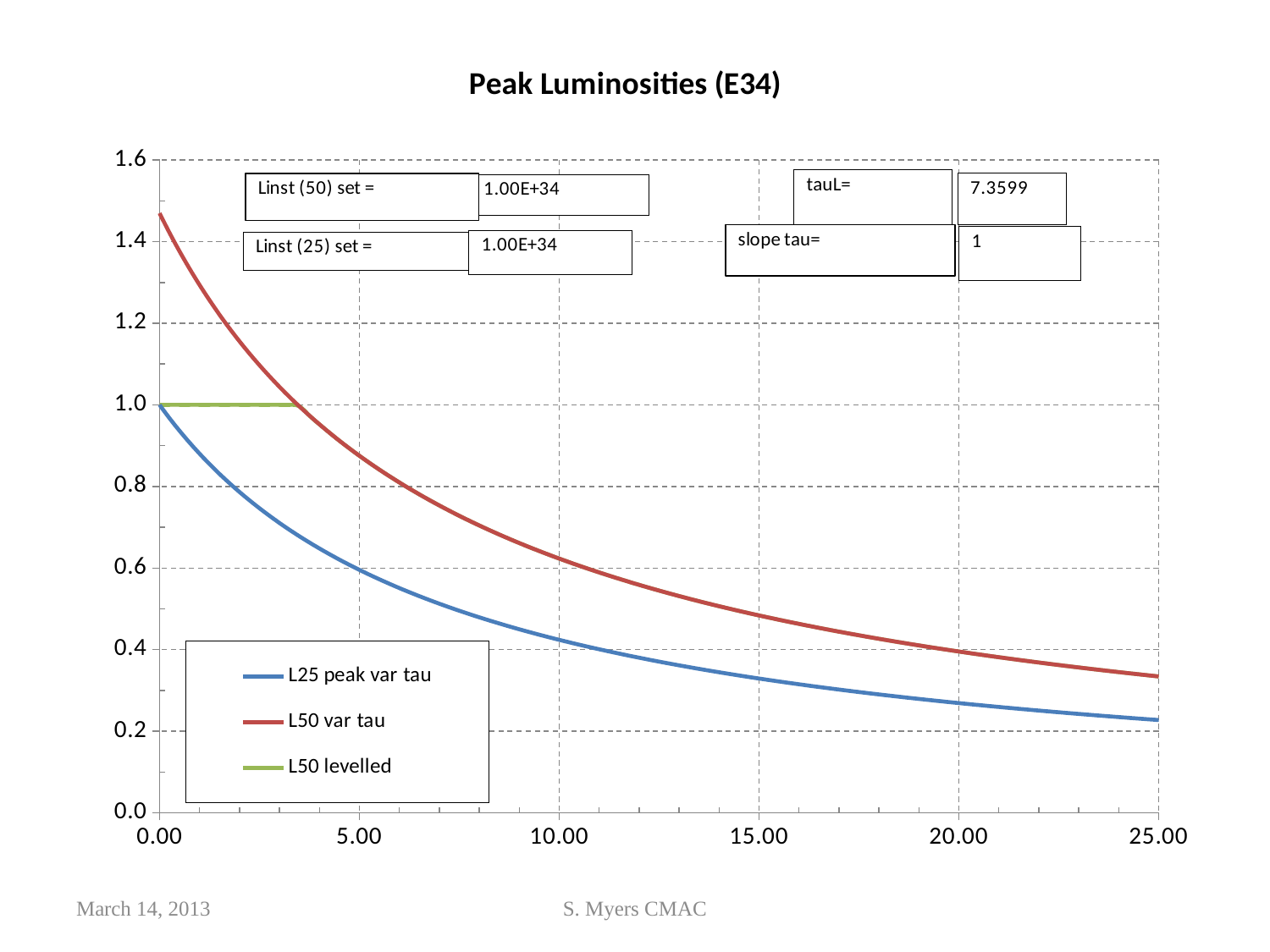
Is the value of L50 var tau at x = 0.00 greater or less than 1.4? greater How many series does the legend list? 3 Is the value of L25 peak var tau at x = 25.00 greater or less than 0.4? less What kind of chart is shown on the slide? line chart Which series has the highest value at x = 15.00? L50 var tau What is the title of the chart? Peak Luminosities (E34) Does the L50 var tau series rise or fall as the x axis increases? fall At x = 10.00, which series is higher, L50 var tau or L25 peak var tau? L50 var tau Is the value of L25 peak var tau at x = 5.00 greater or less than 0.8? less At what constant value does the L50 levelled series run? 1.0 What is the value of L25 peak var tau at x = 0.00? 1.0